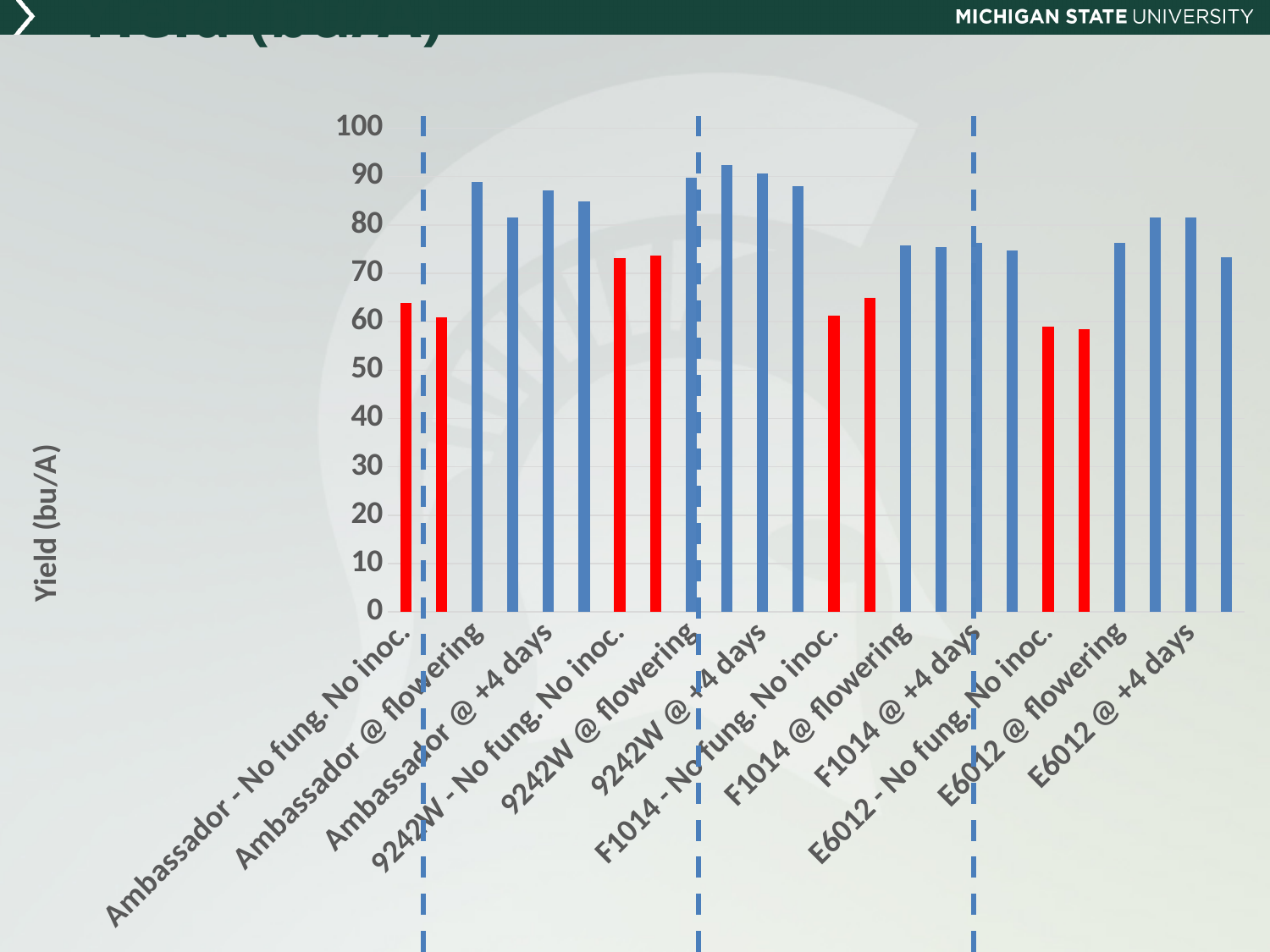
Are both bars for '9242W - No fung. No inoc.' greater or less than 70? greater Are both bars for 'F1014 @ flowering' greater or less than 80? less Which has higher bars: 'F1014 - No fung. No inoc.' or 'Ambassador @ +4 days'? Ambassador @ +4 days Are both bars for 'Ambassador - No fung. No inoc.' greater or less than 70? less What is the y-axis title of the chart? Yield (bu/A) What type of chart is shown on the slide? bar chart